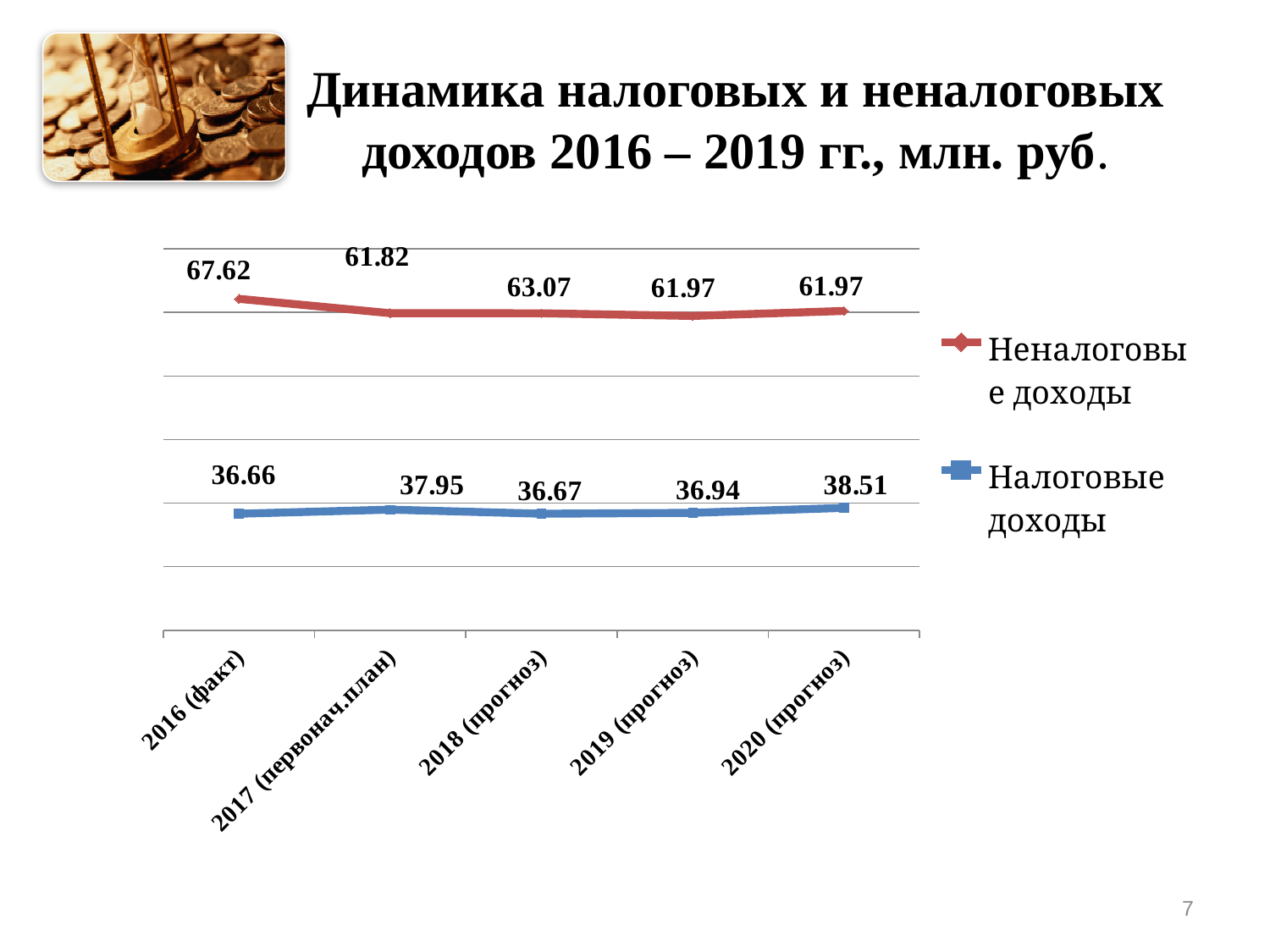
What is the value of Неналоговые доходы for 2018 (прогноз)? 63.07 In which category is Неналоговые доходы highest? 2016 (факт) How many series does the legend list? 2 How many categories are shown on the x axis? 5 What is the value of Налоговые доходы for 2017 (первонач.план)? 37.95 What is the value of Неналоговые доходы for 2016 (факт)? 67.62 What type of chart is shown on the slide? Line chart What is the difference between Неналоговые доходы and Налоговые доходы for 2019 (прогноз)? 25.03 In which category is Налоговые доходы lowest? 2016 (факт) What is the value of Налоговые доходы for 2020 (прогноз)? 38.51 What colour is the line for Налоговые доходы? Blue Which is larger for 2018 (прогноз): Неналоговые доходы or Налоговые доходы? Неналоговые доходы